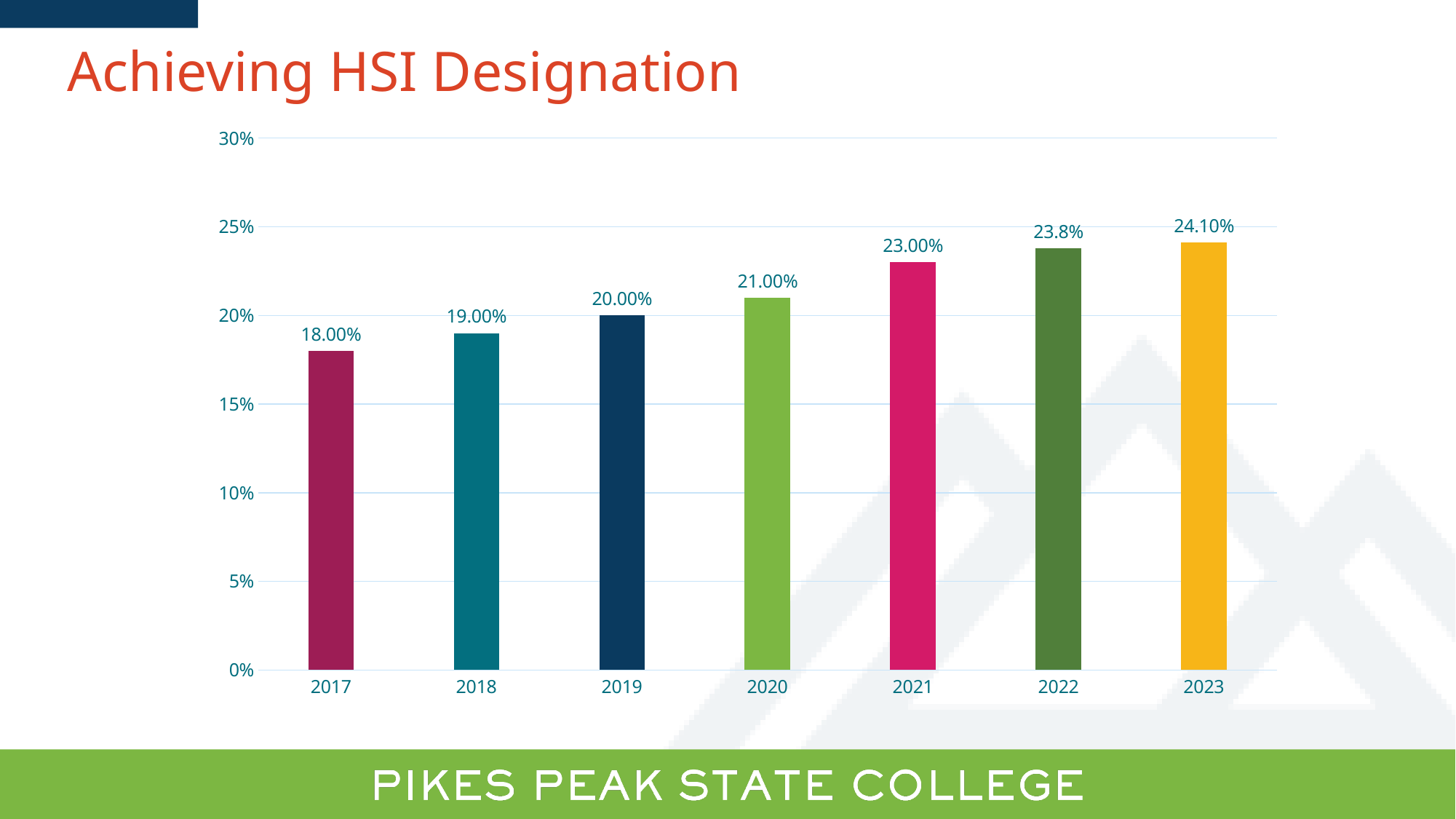
What kind of chart is shown on the slide? bar chart Which year has the highest value? 2023 What is the value for 2017? 18.00% How many years are shown on the x axis? 7 Do the values rise or fall from 2017 to 2023? rise Which is larger, the value for 2019 or the value for 2021? 2021 What is the difference between the values for 2021 and 2018? 4.00% What is the value for 2023? 24.10% What is the value for 2020? 21.00% Is the value for 2022 greater or less than 20%? greater Which year has the lowest value? 2017 What is the value for 2022? 23.8%